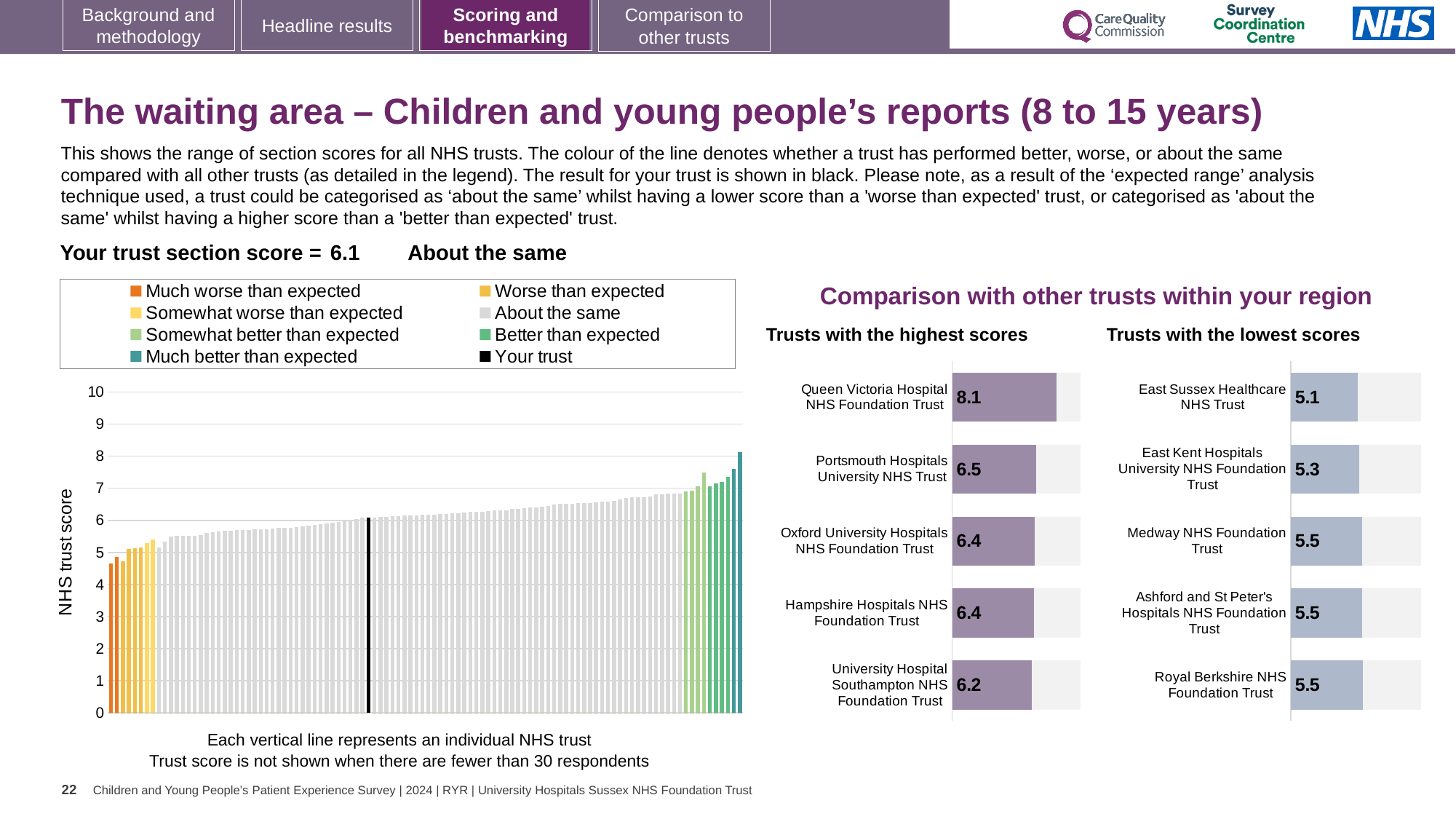
In the 'Trusts with the highest scores' chart, which has the higher score: Portsmouth Hospitals University NHS Trust or Oxford University Hospitals NHS Foundation Trust? Portsmouth Hospitals University NHS Trust How many trusts are shown in the 'Trusts with the highest scores' chart? 5 In the 'Trusts with the lowest scores' chart, what is the score for East Sussex Healthcare NHS Trust? 5.1 In the 'Trusts with the lowest scores' chart, which trust has the lowest score? East Sussex Healthcare NHS Trust How many entries does the legend of the NHS trust score chart list? 8 In the 'Trusts with the highest scores' chart, which trust has the highest score? Queen Victoria Hospital NHS Foundation Trust What kind of chart is the NHS trust score chart on the left? Bar chart In the 'Trusts with the highest scores' chart, what is the difference between the scores of Queen Victoria Hospital NHS Foundation Trust and Portsmouth Hospitals University NHS Trust? 1.6 In the 'Trusts with the highest scores' chart, what is the score for Queen Victoria Hospital NHS Foundation Trust? 8.1 In the NHS trust score chart on the left, do the bars rise or fall from left to right? Rise In the 'Trusts with the lowest scores' chart, what is the difference between the scores of East Kent Hospitals University NHS Foundation Trust and East Sussex Healthcare NHS Trust? 0.2 In the NHS trust score chart on the left, is the value of the lowest bar greater or less than 5? less